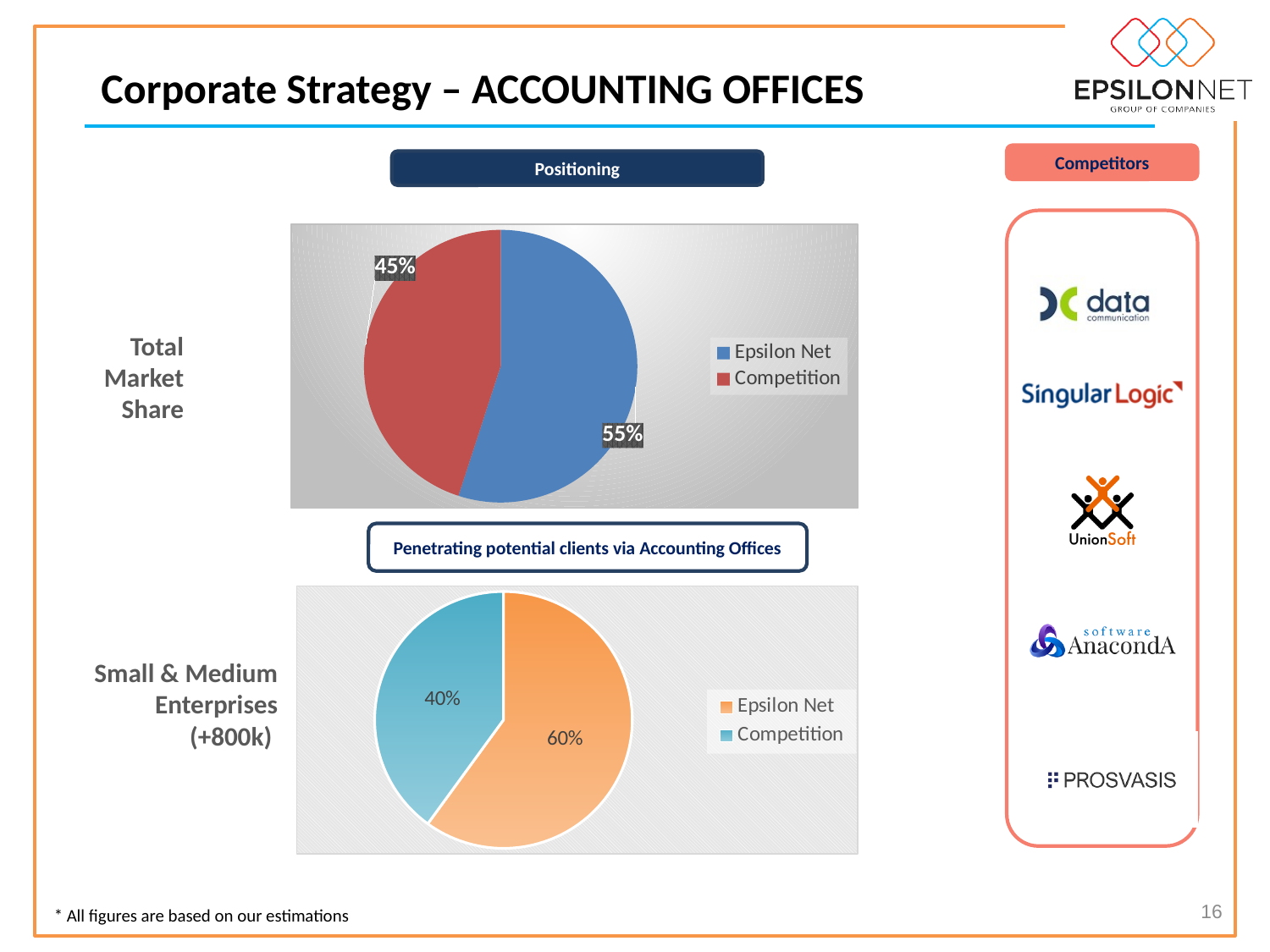
In the bottom pie chart (Small & Medium Enterprises), which is larger, Epsilon Net or Competition? Epsilon Net In the bottom pie chart (Small & Medium Enterprises), what share does Epsilon Net hold? 60% In the top pie chart (Total Market Share), which slice is the largest? Epsilon Net What type of chart is the top chart (Total Market Share)? Pie chart In the bottom pie chart (Small & Medium Enterprises), what share does Competition hold? 40% In the bottom pie chart (Small & Medium Enterprises), what is the difference between the Epsilon Net and Competition shares? 20% In the top pie chart (Total Market Share), what share does Competition hold? 45% In the top pie chart (Total Market Share), what share does Epsilon Net hold? 55% In the bottom pie chart (Small & Medium Enterprises), which slice is the smallest? Competition How many slices does the bottom pie chart (Small & Medium Enterprises) have? 2 How many entries does the legend of the top pie chart (Total Market Share) list? 2 In the top pie chart (Total Market Share), what is the difference between the Epsilon Net and Competition shares? 10%